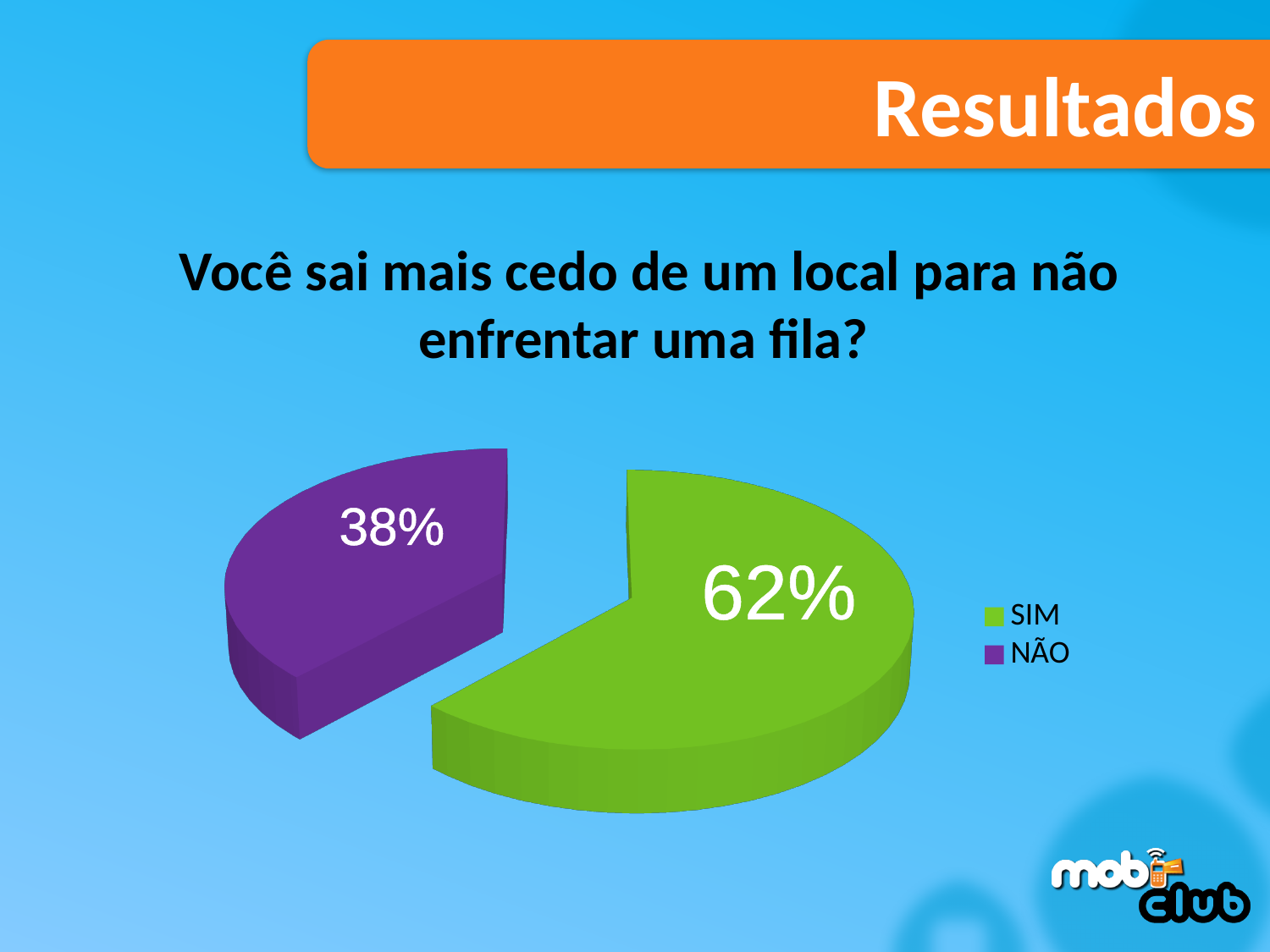
How many slices does the pie chart have? 2 How many entries does the legend list? 2 Is the share for NÃO greater or less than 50%? less Which slice is larger, SIM or NÃO? SIM What percentage of respondents answered SIM? 62% What is the difference in percentage points between the SIM and NÃO slices? 24 Which response has the smallest share of the pie? NÃO What type of chart is shown on the slide? pie chart What question does the chart present results for? Você sai mais cedo de um local para não enfrentar uma fila? What colour is the SIM slice? green What percentage of respondents answered NÃO? 38% Which response has the largest share of the pie? SIM